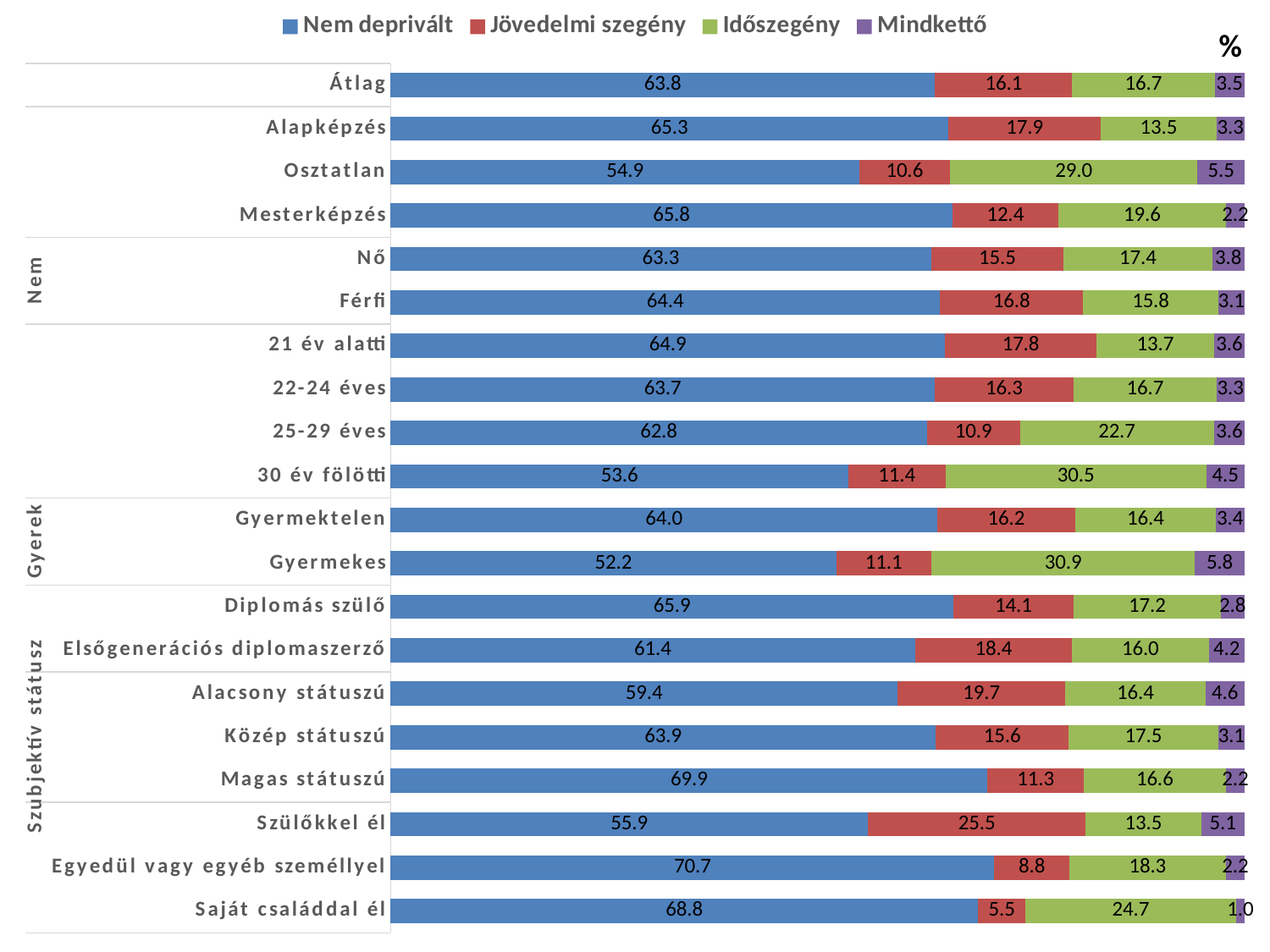
Which category has the lowest Nem deprivált value? Gyermekes What type of chart is shown on the slide? Stacked bar chart How many categories are plotted on the chart? 20 What is the difference between the Időszegény values for Osztatlan and Alapképzés? 15.5 Which category has the lowest Jövedelmi szegény value? Saját családdal él Which is larger, the Jövedelmi szegény value for Alacsony státuszú or for Magas státuszú? Alacsony státuszú What is the Mindkettő value for Saját családdal él? 1.0 What is the Időszegény value for Osztatlan? 29.0 How many series does the legend list? 4 Which category has the highest Nem deprivált value? Egyedül vagy egyéb személlyel What is the Nem deprivált value for Átlag? 63.8 What is the Jövedelmi szegény value for Szülőkkel él? 25.5